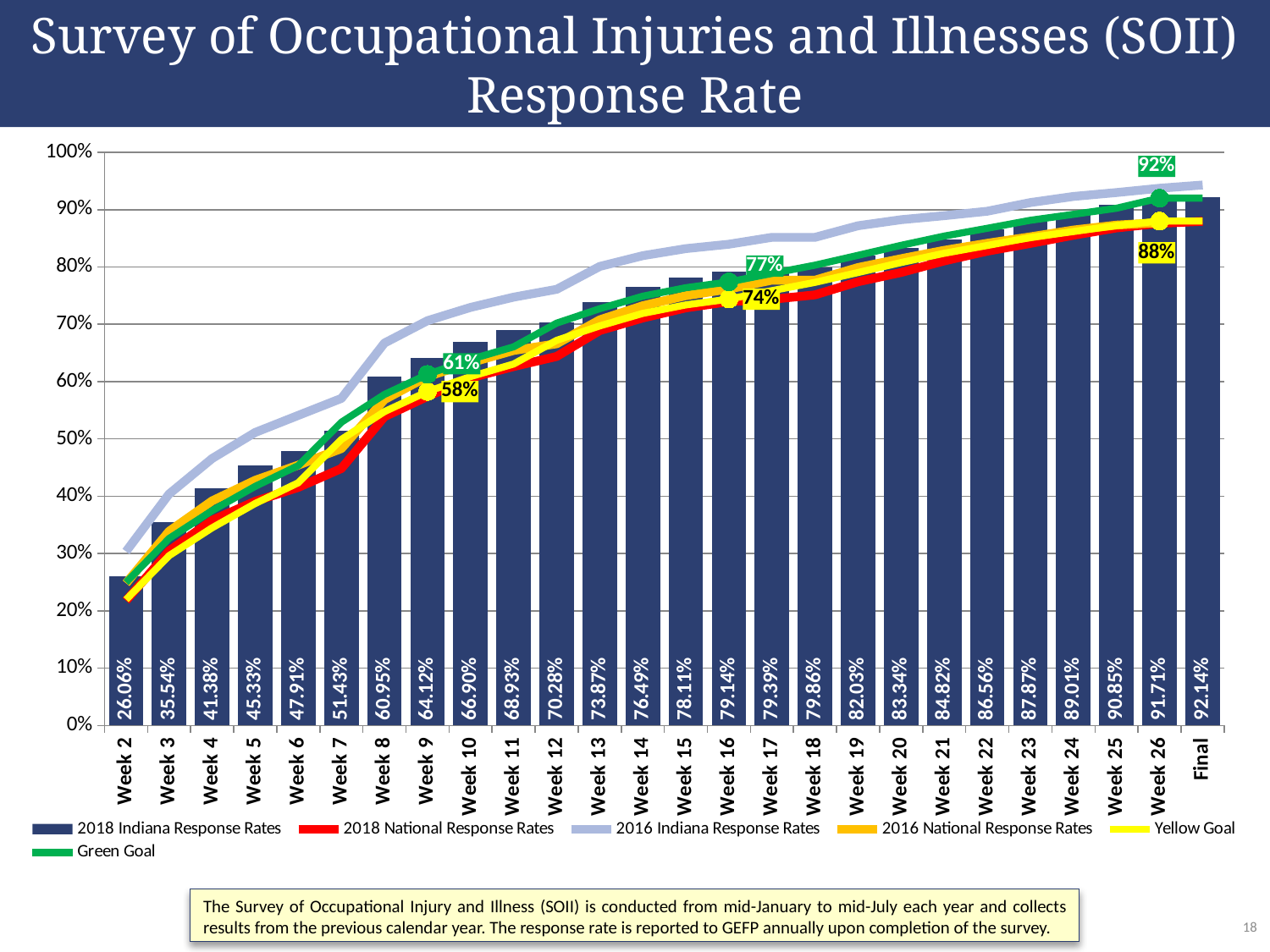
How many series does the legend list? 6 Which is larger, the 2018 Indiana Response Rate for Week 13 or for Week 12? Week 13 Which category has the lowest 2018 Indiana Response Rate? Week 2 How many categories are shown on the x axis? 26 What is the Yellow Goal value labelled at Week 9? 58% What is the difference between the 2018 Indiana Response Rates for Week 10 and Week 9? 2.78% Do the 2018 Indiana Response Rates rise or fall from Week 2 to Final? rise Is the 2016 Indiana Response Rate for Week 2 greater or less than 40%? less What is the 2018 Indiana Response Rate for Week 16? 79.14% What is the Green Goal value labelled at Week 26? 92% What is the 2018 Indiana Response Rate for Week 2? 26.06% What is the Final 2018 Indiana Response Rate? 92.14%